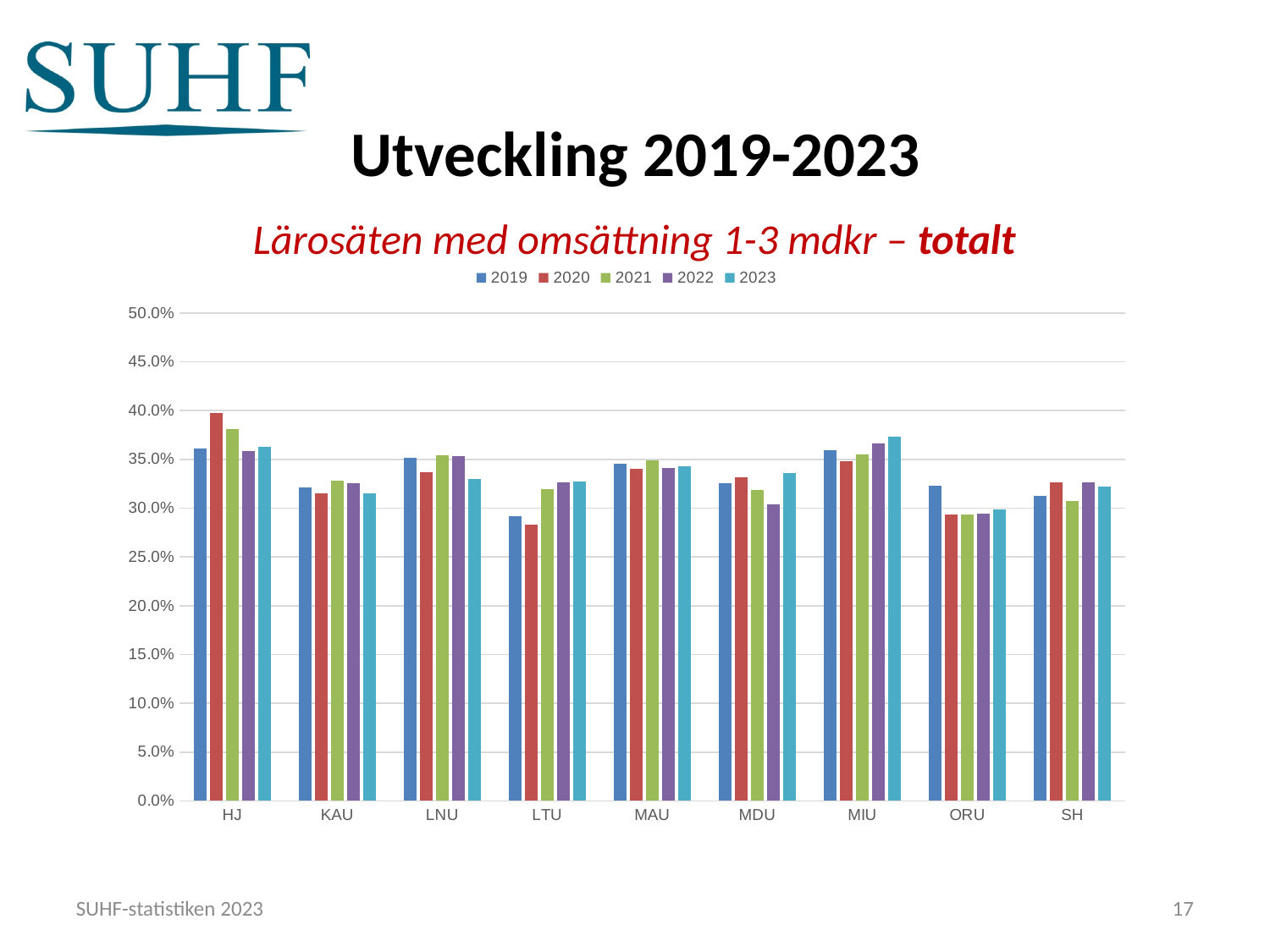
What kind of chart is shown on the slide? bar chart Which institution has the single highest bar in the chart? HJ Which is larger for LTU: the value for 2019 or the value for 2023? 2023 Is the value for LTU in 2020 greater or less than 30.0%? less Is the value for HJ in 2020 greater or less than 35.0%? greater How many series does the legend list? 5 Which institution has the single lowest bar in the chart? LTU For ORU, which year has the highest value? 2019 Is the value for MIU in 2023 greater or less than 35.0%? greater For HJ, which year has the highest value? 2020 What is the subtitle of the chart shown below the main title? Lärosäten med omsättning 1-3 mdkr – totalt How many institutions (categories) are shown on the x axis? 9